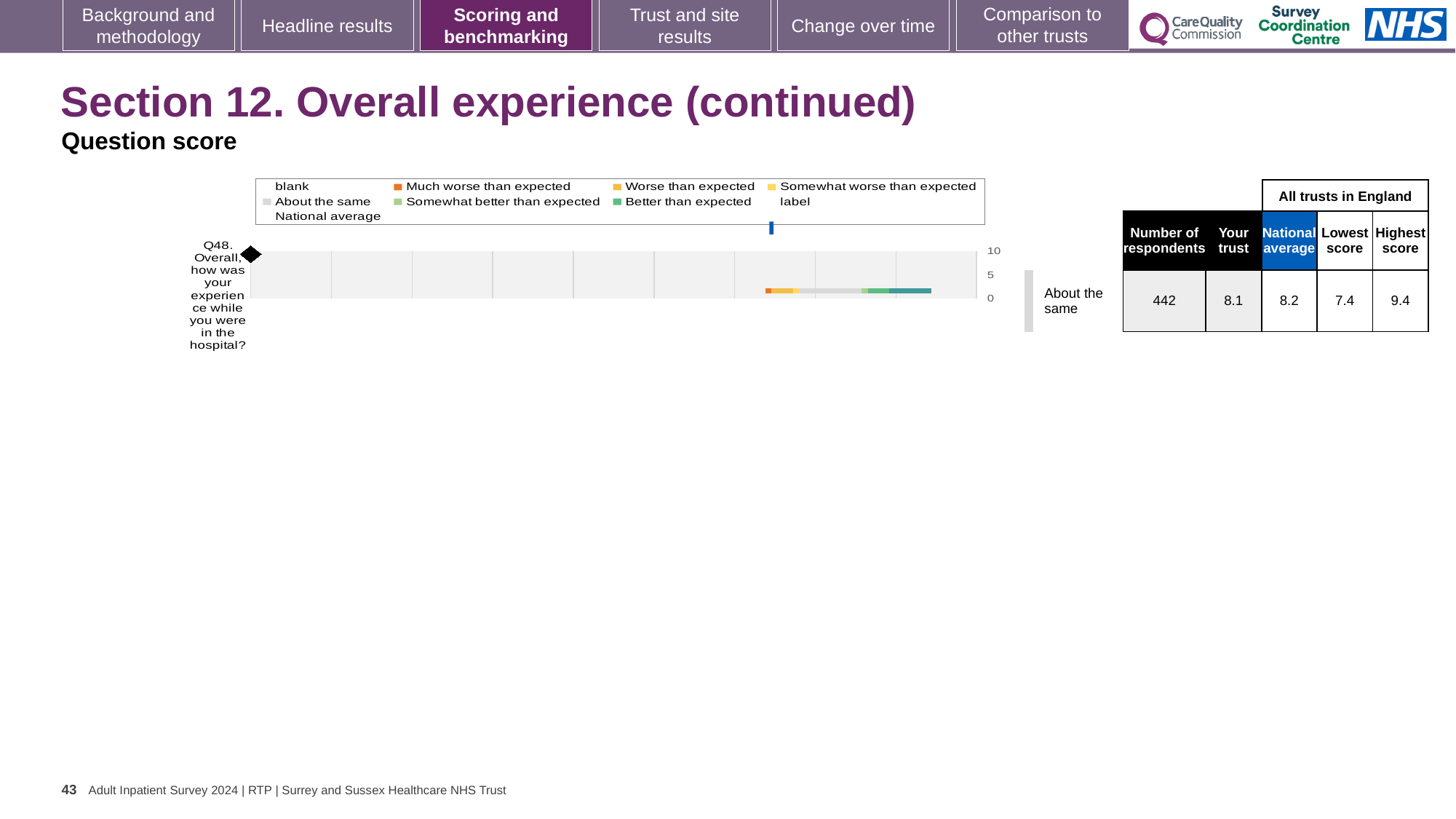
What is the national average score for Q48 shown next to the chart? 8.2 What is the 'Your trust' score for Q48 shown next to the chart? 8.1 What is the lowest score among all trusts in England for Q48? 7.4 Which benchmarking category is the trust's Q48 result placed in? About the same How many survey questions are plotted on the chart? 1 Which question is plotted on the chart? Q48. Overall, how was your experience while you were in the hospital? What is the highest score among all trusts in England for Q48? 9.4 What is the highest value shown on the chart's axis? 10 Which is larger for Q48, the trust's score or the national average? national average What kind of chart is shown on the slide? bar chart How many respondents answered Q48? 442 What is the difference between the highest and lowest scores among all trusts in England for Q48? 2.0